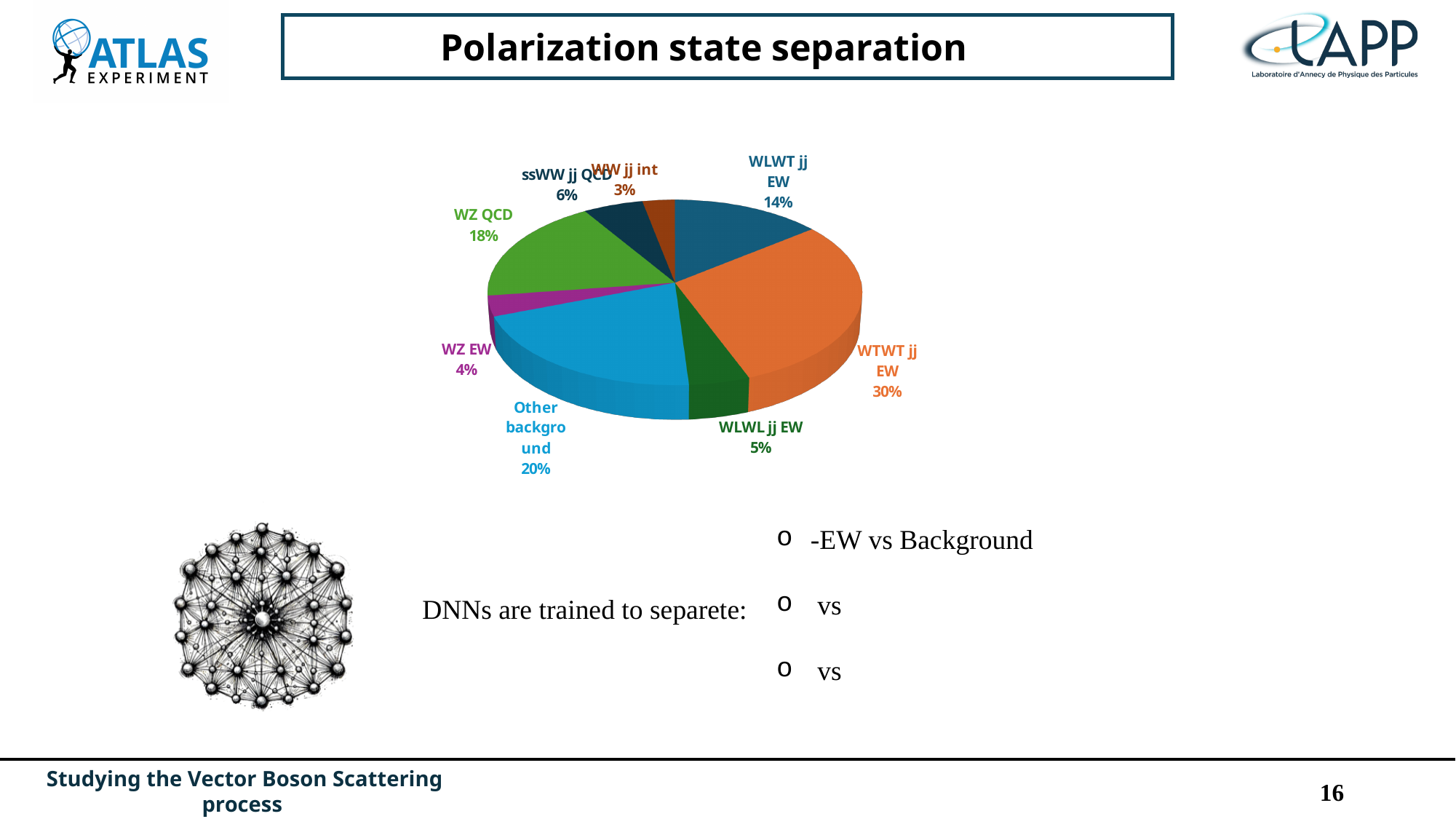
What share of the pie does WLWT jj EW have? 14% What kind of chart is shown on the slide? pie chart What share of the pie does WW jj int have? 3% How many slices does the pie chart have? 8 Which is larger, the share for WZ QCD or the share for ssWW jj QCD? WZ QCD What share of the pie does WTWT jj EW have? 30% Which slice of the pie is the largest? WTWT jj EW What is the difference in percentage points between WLWL jj EW and WZ EW? 1 What is the difference in percentage points between WTWT jj EW and WLWT jj EW? 16 Which slice of the pie is the smallest? WW jj int